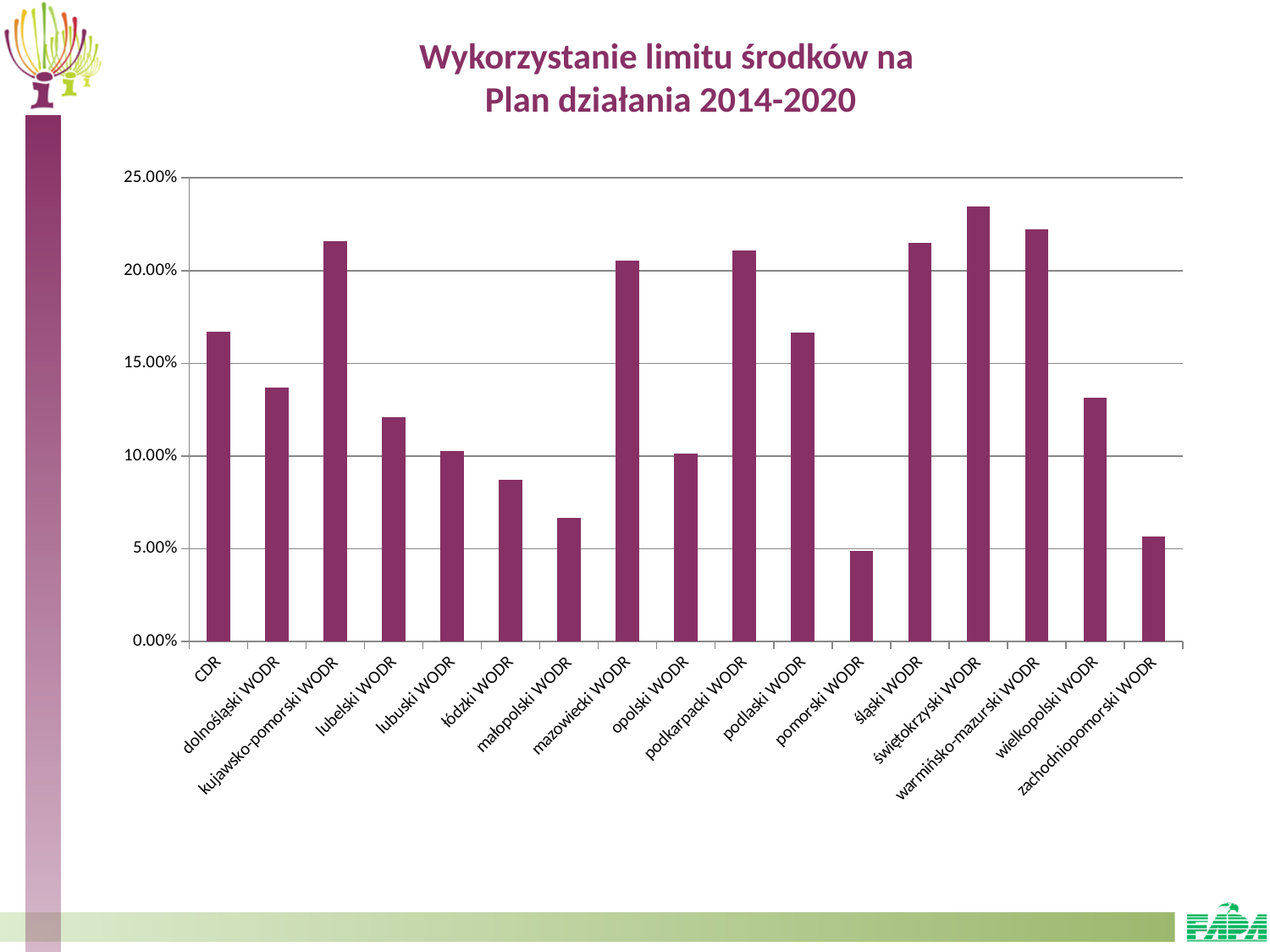
What is the title of the chart? Wykorzystanie limitu środków na Plan działania 2014-2020 What kind of chart is shown on the slide? bar chart Is the value for kujawsko-pomorski WODR greater or less than 20.00%? greater Is the value for CDR greater or less than 15.00%? greater Is the value for wielkopolski WODR greater or less than 15.00%? less Which is larger, the value for kujawsko-pomorski WODR or the value for dolnośląski WODR? kujawsko-pomorski WODR Which category has the highest value? świętokrzyski WODR Which category has the lowest value? pomorski WODR Which is larger, the value for małopolski WODR or the value for mazowiecki WODR? mazowiecki WODR How many categories are plotted on the x axis? 17